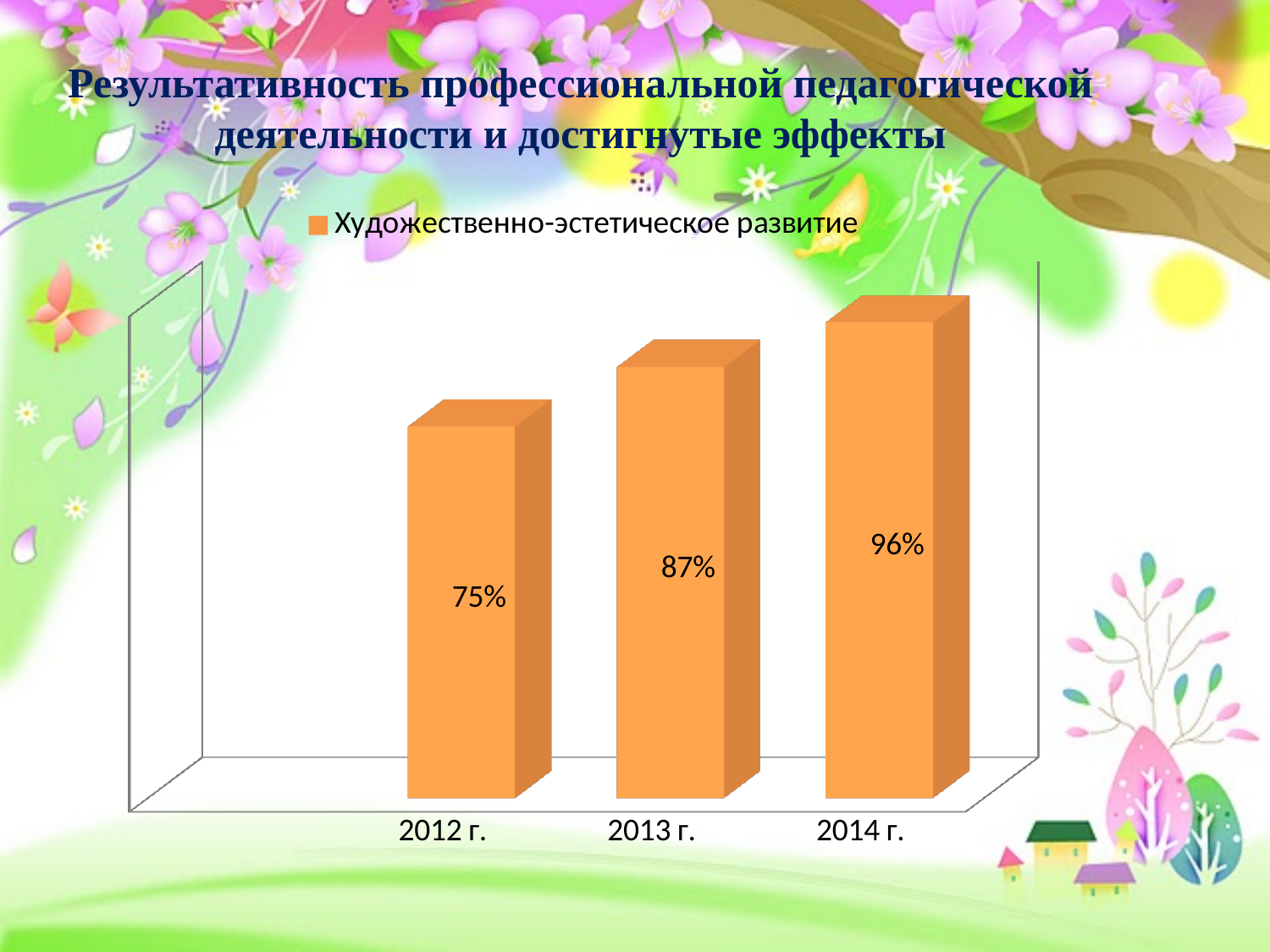
What is the difference between the values for 2013 г. and 2012 г.? 12% What is the difference between the values for 2014 г. and 2012 г.? 21% What is the value for 2014 г.? 96% Which year has the lowest value? 2012 г. How many series does the legend list? 1 Do the values rise or fall from 2012 г. to 2014 г.? rise Which is larger, the value for 2013 г. or the value for 2014 г.? 2014 г. Which year has the highest value? 2014 г. What is the value for 2012 г.? 75% What is the value for 2013 г.? 87% How many years are shown on the x axis? 3 What kind of chart is shown on the slide? bar chart